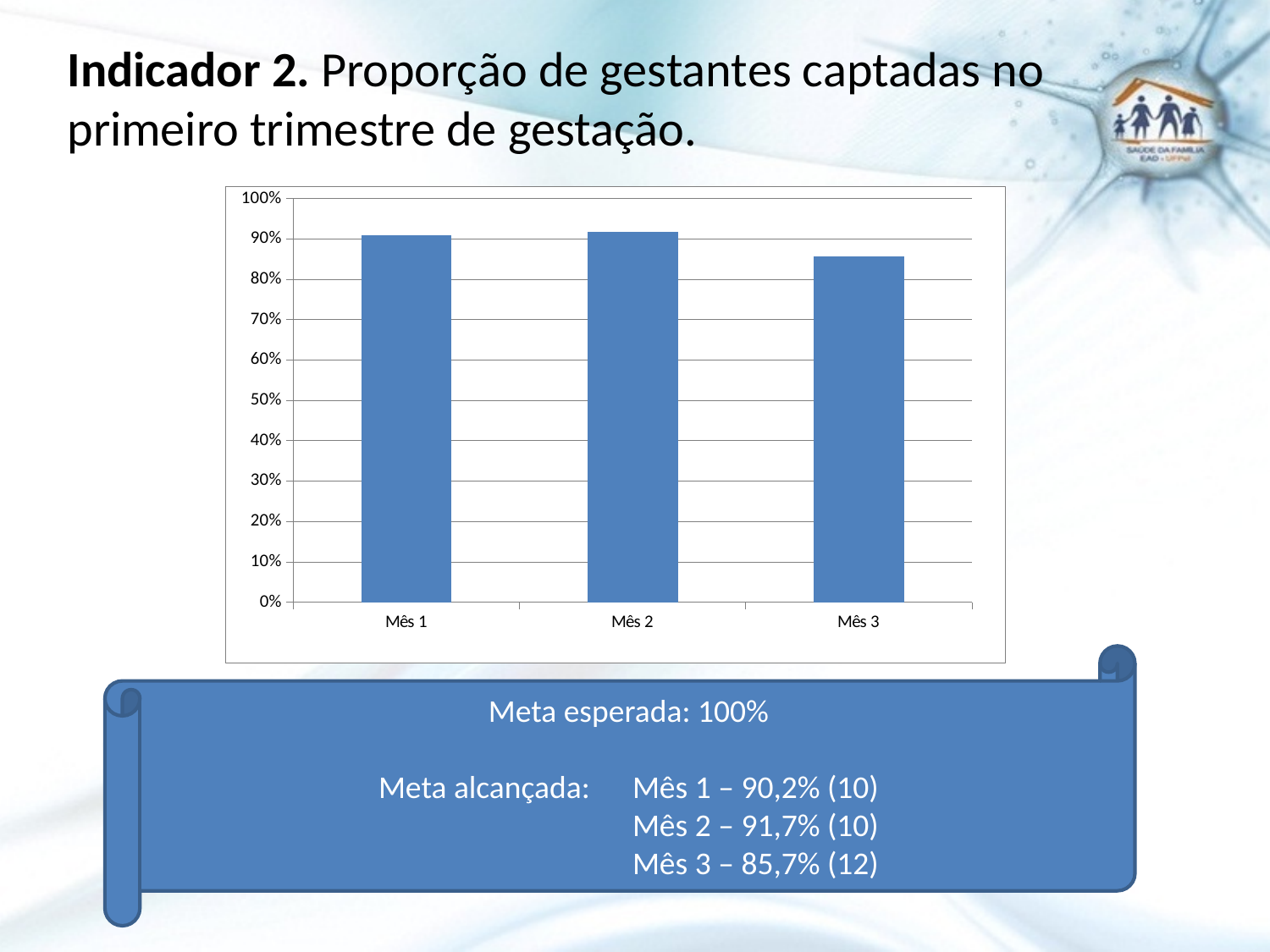
What is the difference between the values for Mês 2 (91,7%) and Mês 3 (85,7%)? 6,0 percentage points Is the value for Mês 3 greater or less than 90%? less Is the value for Mês 3 greater or less than 80%? greater What is the expected target (meta esperada) stated on the slide? 100% Which month has the highest value in the chart? Mês 2 According to the slide, what value was reached in Mês 3? 85,7% Do the values rise or fall from Mês 2 to Mês 3? fall According to the slide, what value was reached in Mês 1? 90,2% Is the value for Mês 2 greater or less than 80%? greater How many months (categories) are plotted in the chart? 3 Which month has the lowest bar in the chart? Mês 3 What kind of chart is shown on the slide? Bar chart